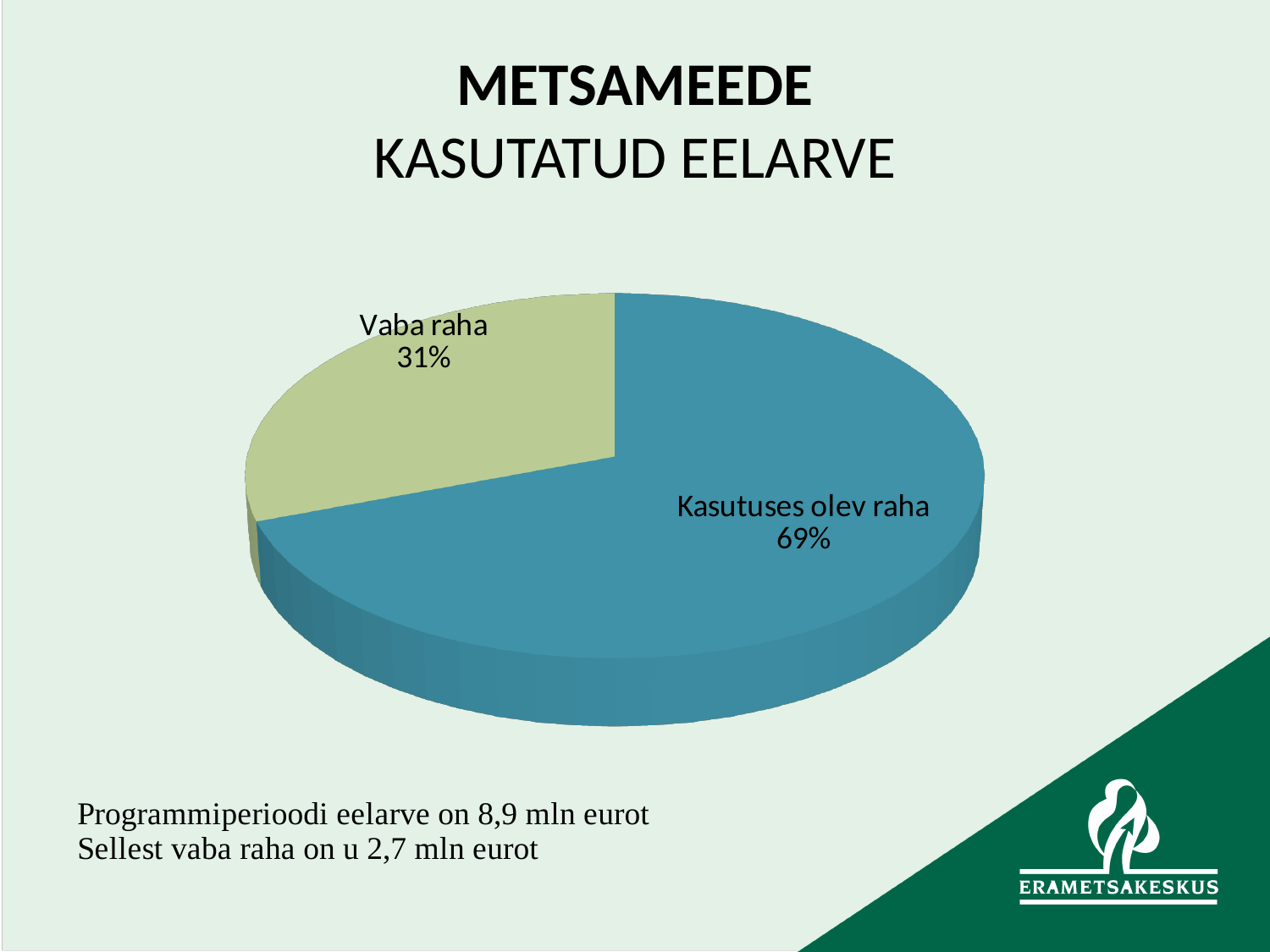
What kind of chart is shown on the slide? pie chart What share of the pie does "Kasutuses olev raha" represent? 69% Which is larger, the share for "Vaba raha" or the share for "Kasutuses olev raha"? Kasutuses olev raha Which slice of the pie is the smallest? Vaba raha What is the title of the chart on the slide? METSAMEEDE KASUTATUD EELARVE What is the difference in percentage points between "Kasutuses olev raha" and "Vaba raha"? 38 What colour is the "Vaba raha" slice of the pie? light green What share of the pie does "Vaba raha" represent? 31% Which slice of the pie is the largest? Kasutuses olev raha How many slices does the pie chart have? 2